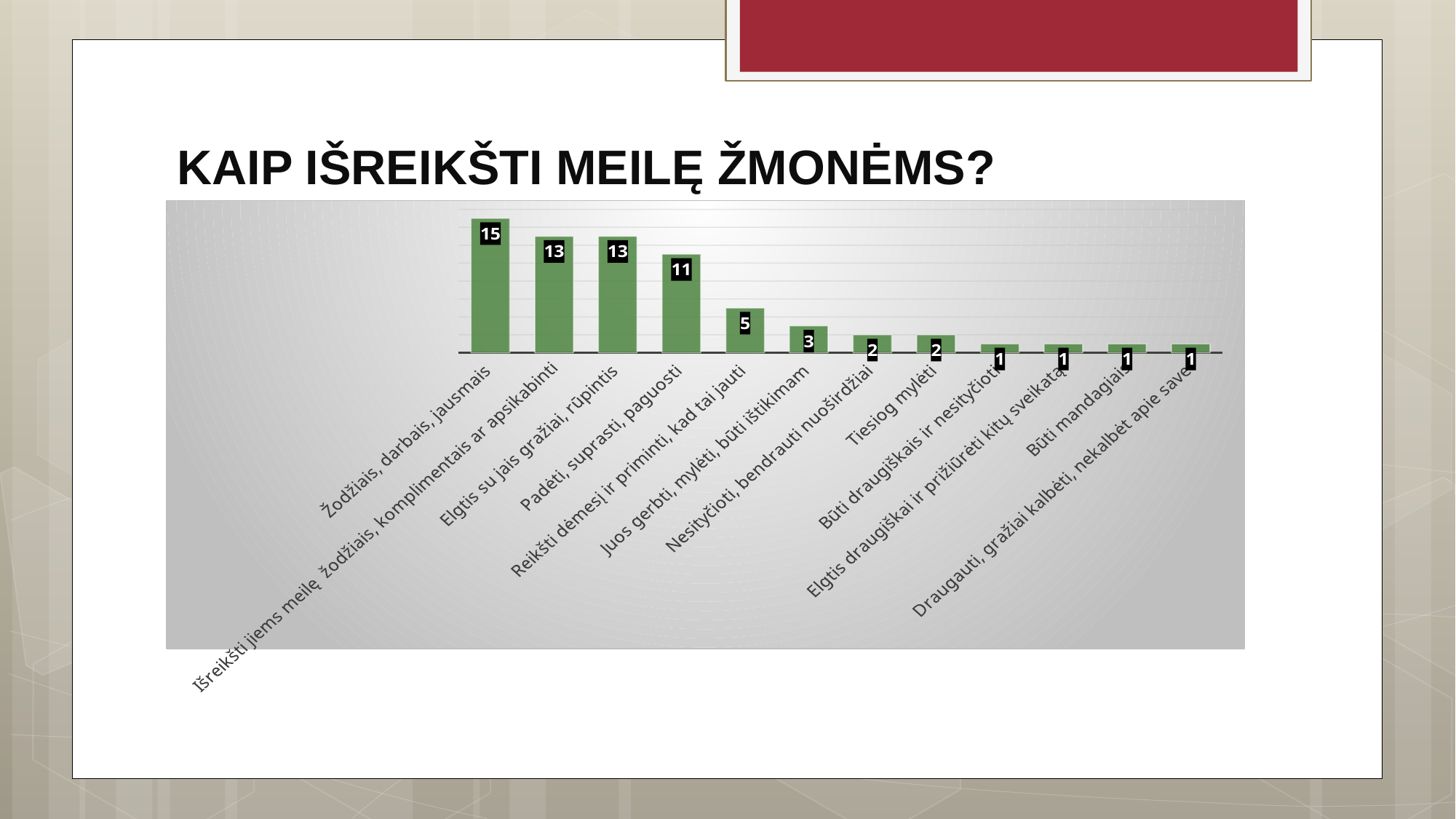
What kind of chart is shown on the slide? Bar chart What is the value for "Juos gerbti, mylėti, būti ištikimam"? 3 What is the value for "Žodžiais, darbais, jausmais"? 15 What is the difference between the values for "Elgtis su jais gražiai, rūpintis" and "Reikšti dėmesį ir priminti, kad tai jauti"? 8 How many categories are shown in the chart? 12 Which category has the highest value? Žodžiais, darbais, jausmais What is the value for "Reikšti dėmesį ir priminti, kad tai jauti"? 5 What is the value for "Padėti, suprasti, paguosti"? 11 Which is larger, the value for "Juos gerbti, mylėti, būti ištikimam" or the value for "Būti mandagiais"? Juos gerbti, mylėti, būti ištikimam What is the difference between the values for "Žodžiais, darbais, jausmais" and "Padėti, suprasti, paguosti"? 4 What is the value for "Tiesiog mylėti"? 2 Do the values rise or fall from left to right along the x axis? Fall